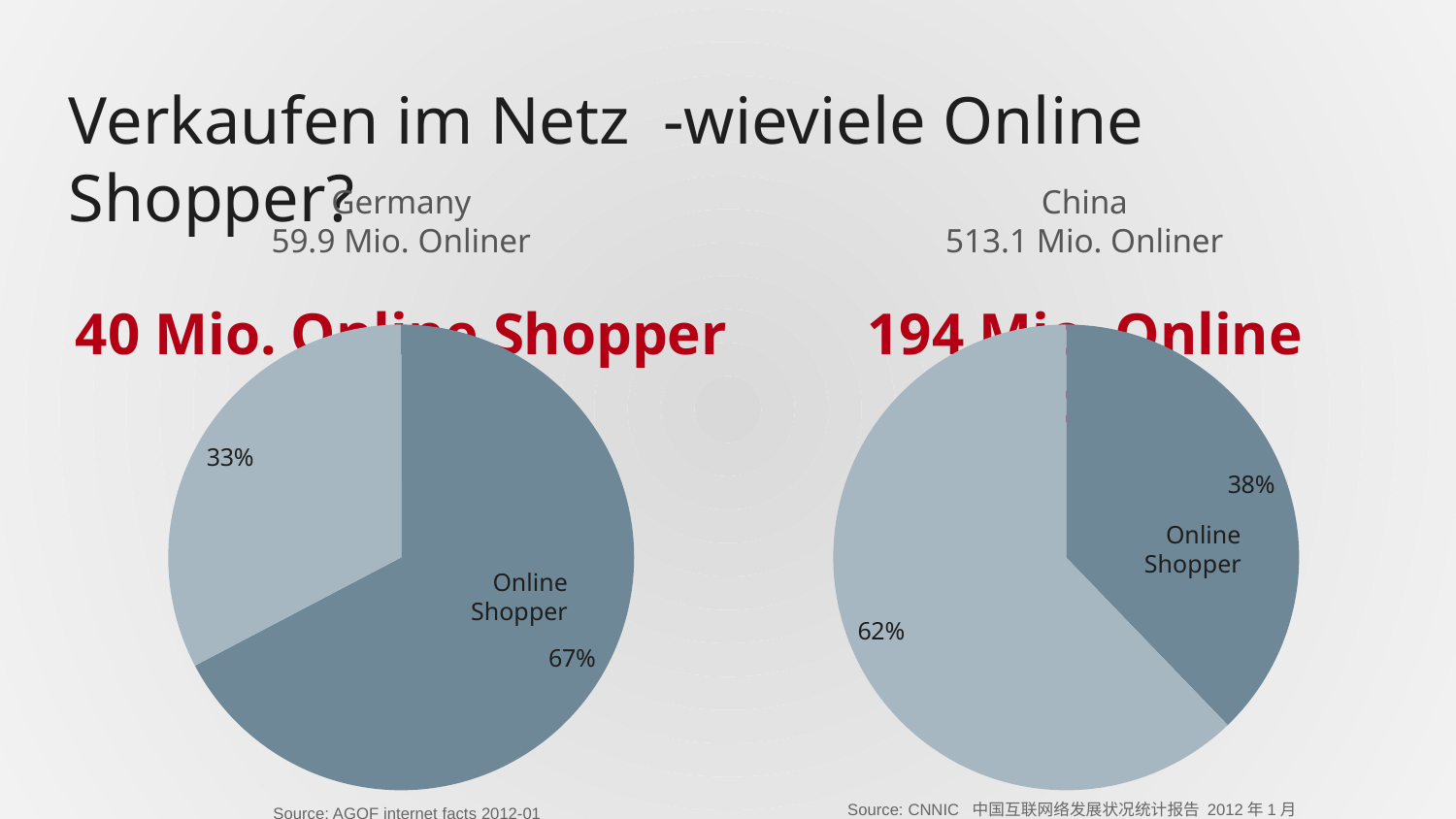
How many slices does the China pie chart (right) have? 2 What is the difference between the Online Shopper share on the Germany chart (67%) and on the China chart (38%)? 29 percentage points On the China pie chart (right), what is the difference between the 62% slice and the 38% Online Shopper slice? 24 percentage points How many slices does the Germany pie chart (left) have? 2 On the Germany pie chart (left), what share is labelled Online Shopper? 67% What kind of chart is used for Germany on the left? Pie chart On the China pie chart (right), which slice is the smallest? Online Shopper On the China pie chart (right), what percentage is shown for the slice that is not Online Shopper? 62% On the Germany pie chart (left), what percentage is shown for the slice that is not Online Shopper? 33% Which pie chart shows the larger Online Shopper share, Germany (left) or China (right)? Germany On the Germany pie chart (left), which slice is the largest? Online Shopper On the China pie chart (right), what share is labelled Online Shopper? 38%